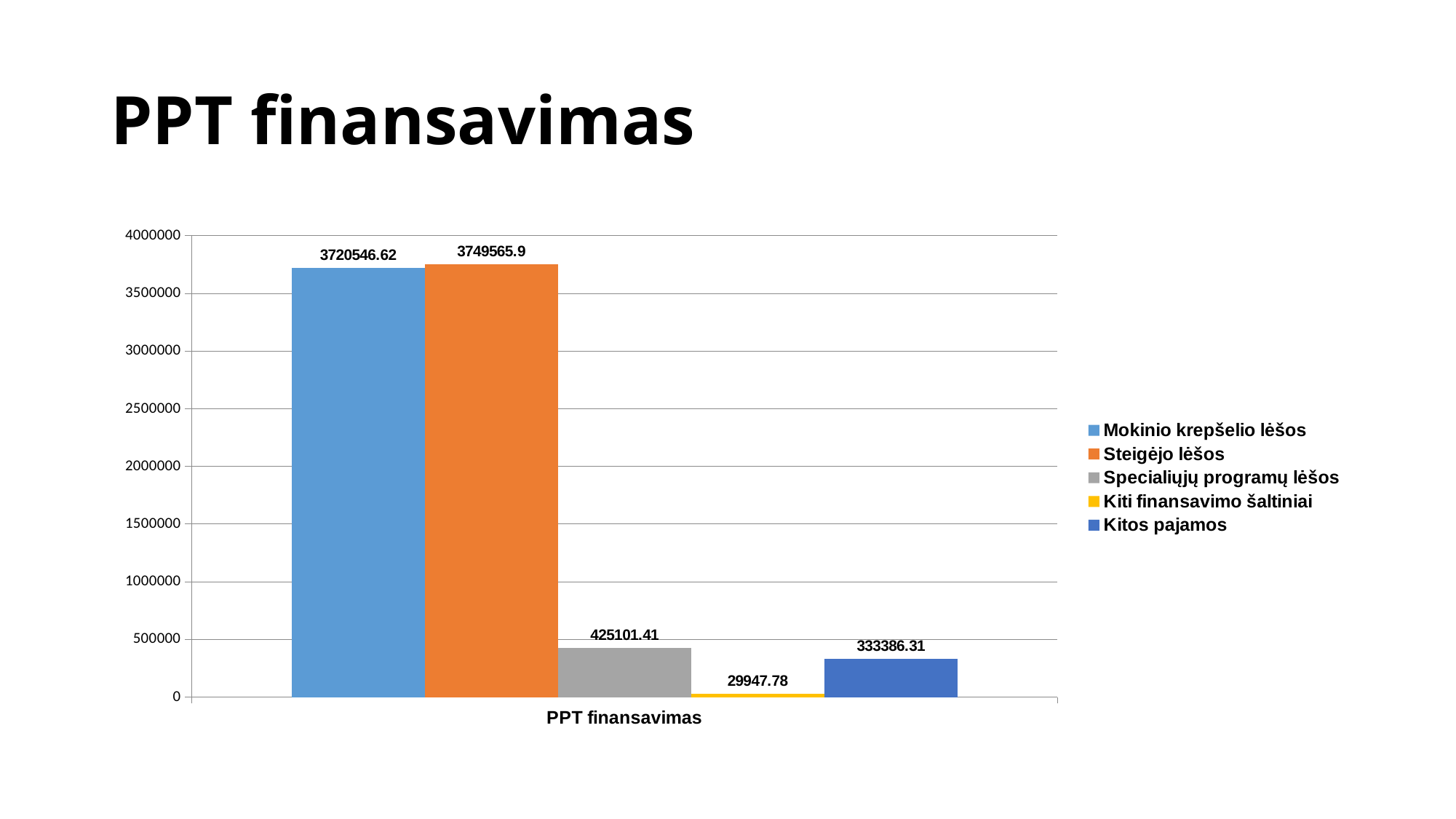
What is the value for Steigėjo lėšos? 3749565.9 What is the value for Kiti finansavimo šaltiniai? 29947.78 What kind of chart is shown on the slide? Bar chart What is the difference between Specialiųjų programų lėšos and Kitos pajamos? 91715.1 How many series does the legend list? 5 What is the difference between Steigėjo lėšos and Mokinio krepšelio lėšos? 29019.28 Which series has the lowest value? Kiti finansavimo šaltiniai What is the value for Kitos pajamos? 333386.31 What is the value for Mokinio krepšelio lėšos? 3720546.62 Which is larger, Kitos pajamos or Specialiųjų programų lėšos? Specialiųjų programų lėšos Which series has the highest value? Steigėjo lėšos What is the value for Specialiųjų programų lėšos? 425101.41